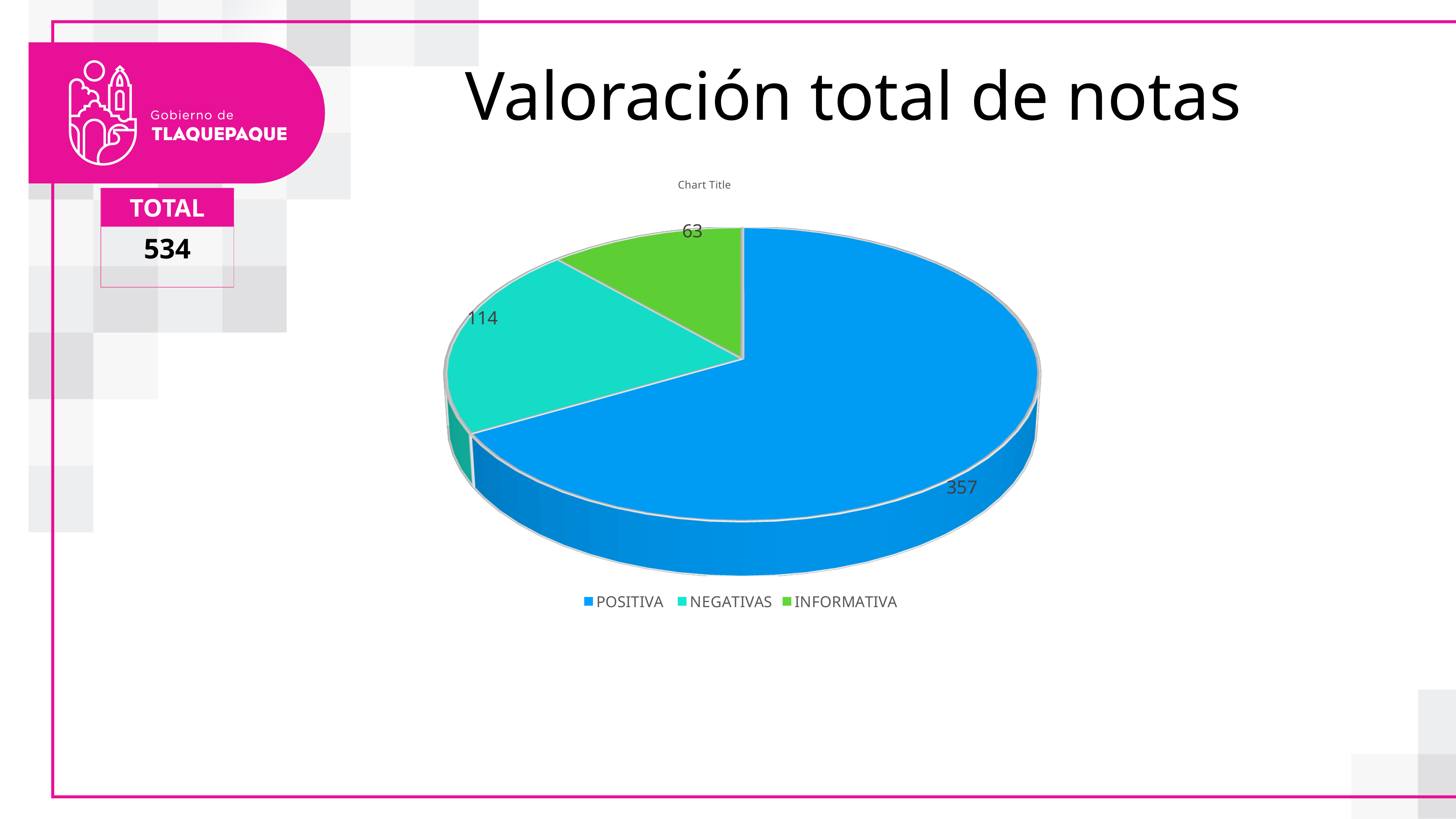
What is the value for INFORMATIVA in the pie chart? 63 What colour is the POSITIVA slice in the pie chart? Blue How many categories does the pie chart show? 3 What is the total of all slices in the pie chart? 534 What is the value for POSITIVA in the pie chart? 357 What kind of chart is shown on the slide? Pie chart What is the value for NEGATIVAS in the pie chart? 114 Which category has the largest slice in the pie chart? POSITIVA Which category has the smallest slice in the pie chart? INFORMATIVA What is the difference between the POSITIVA and NEGATIVAS values? 243 What is the difference between the NEGATIVAS and INFORMATIVA values? 51 Which is larger, NEGATIVAS or INFORMATIVA? NEGATIVAS